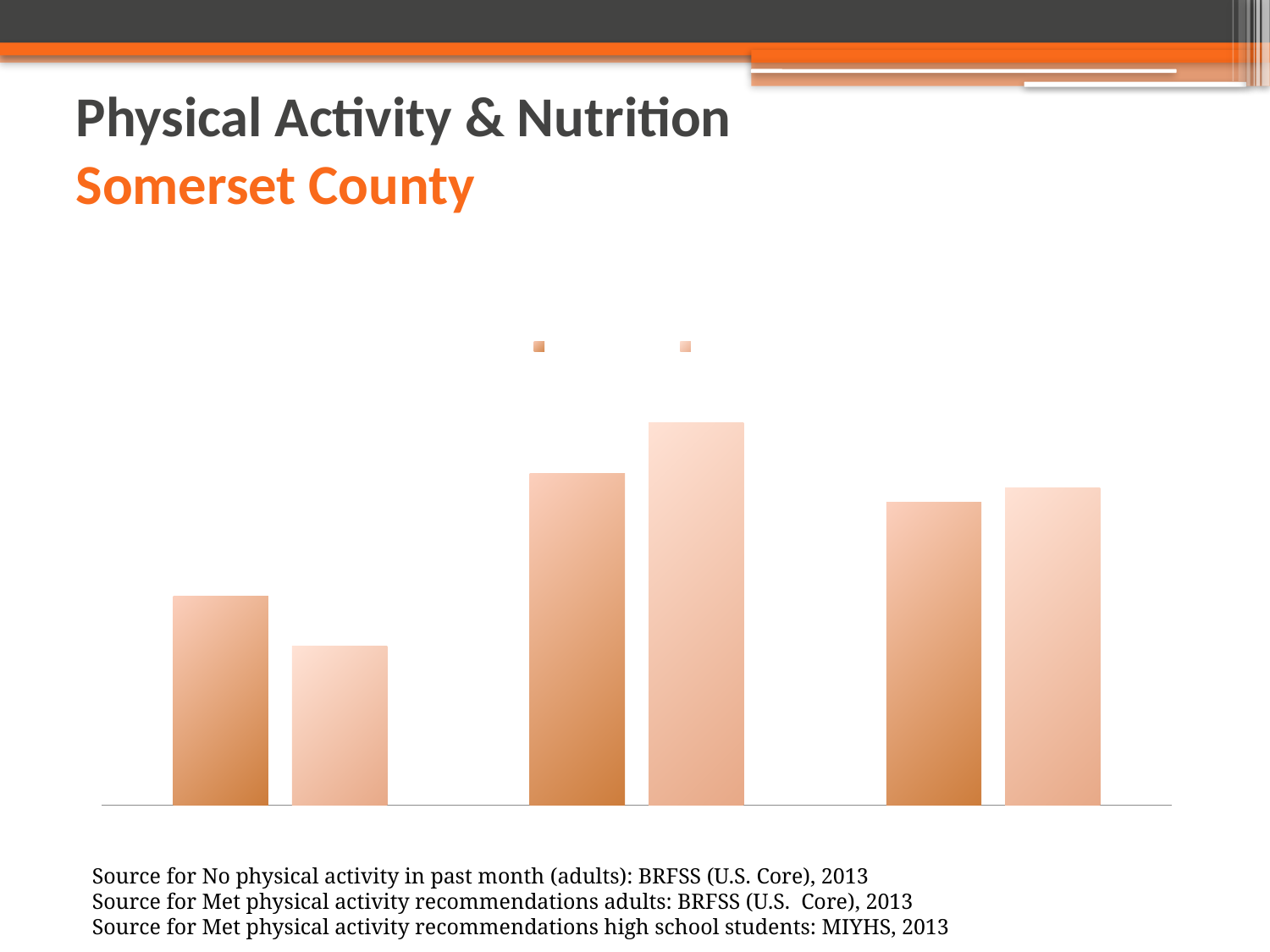
In the right group of bars, is the left bar or the right bar taller? the right bar In the middle group of bars, is the left bar or the right bar taller? the right bar How many bars are plotted in the chart? 6 Which group of bars, from left to right, contains the tallest bar? the middle group How many series does the chart's legend list? 2 Which group of bars, from left to right, contains the shortest bar? the left group What kind of chart is shown on the slide? bar chart Does the chart display a vertical value axis with tick labels? No How many groups of bars does the chart show? 3 What colour are the bars in the chart? orange In the left group of bars, is the left bar or the right bar taller? the left bar